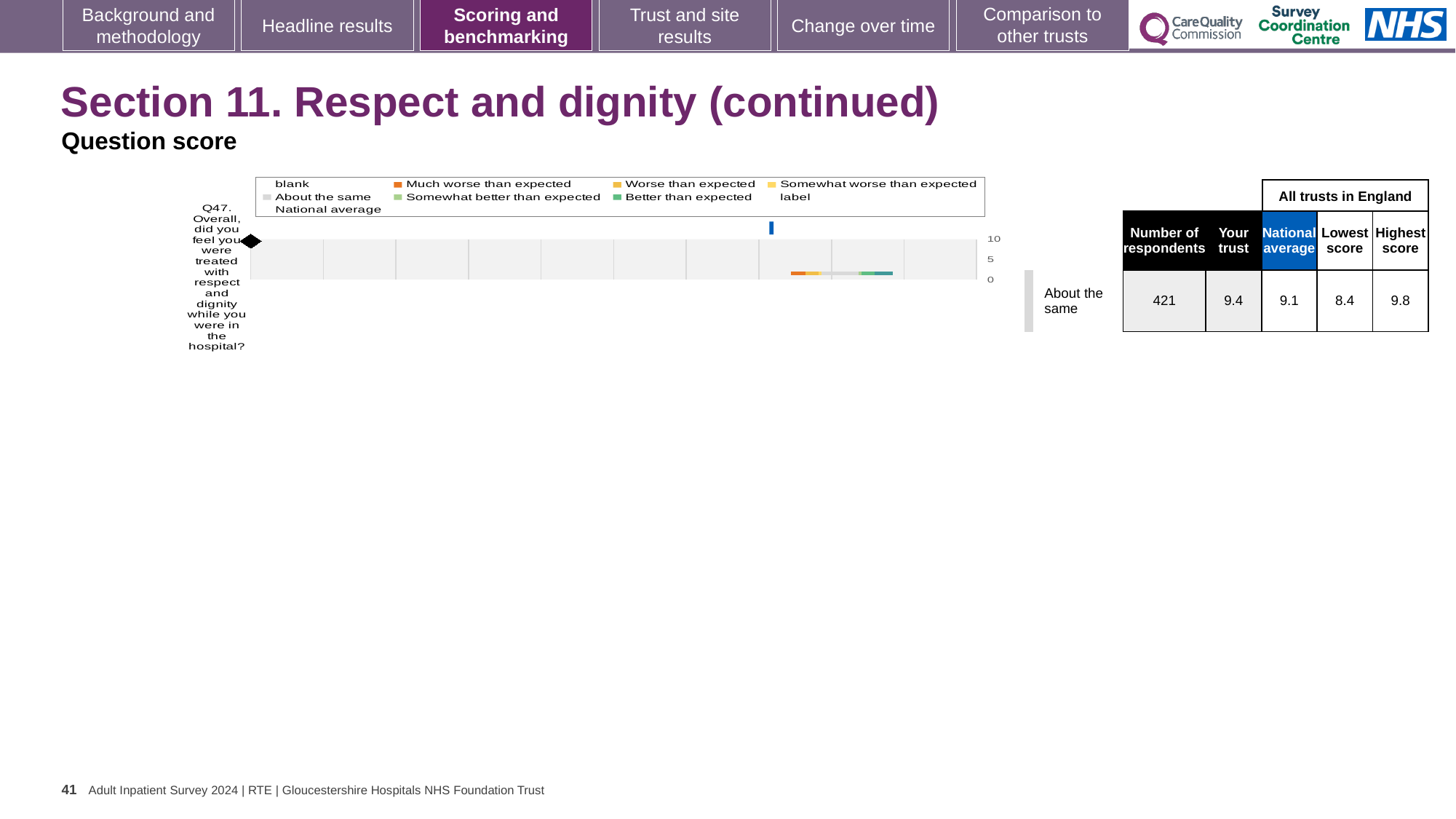
What kind of chart is shown on the slide? bar chart What is the difference between the highest score and the lowest score for Q47 in the table beside the chart? 1.4 How many respondents answered Q47, according to the table beside the chart? 421 According to the table beside the chart, what is the highest score among all trusts in England for Q47? 9.8 How many survey questions are plotted on the chart? 1 According to the table beside the chart, what is the lowest score among all trusts in England for Q47? 8.4 Which question is plotted on the chart? Q47. Overall, did you feel you were treated with respect and dignity while you were in the hospital? What is the highest tick value shown on the chart's axis? 10 Which is larger for Q47: the 'Your trust' score or the national average? Your trust What benchmark category is the trust's Q47 result labelled as next to the chart? About the same According to the table beside the chart, what is the national average score for Q47? 9.1 According to the table beside the chart, what is the 'Your trust' score for Q47? 9.4